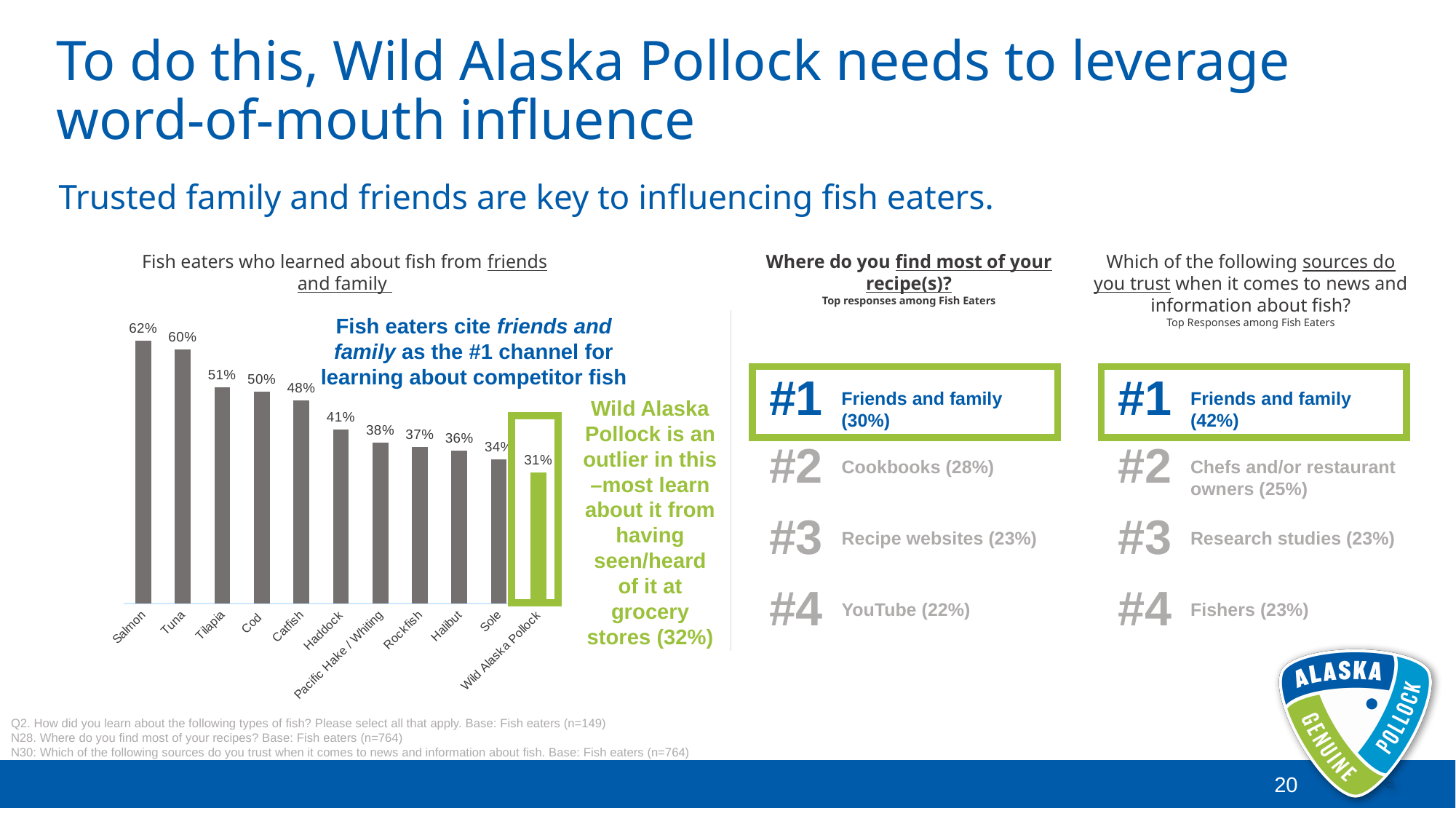
Which fish has the lowest share of fish eaters who learned about it from friends and family? Wild Alaska Pollock Which has a higher value, Tilapia or Rockfish? Tilapia What is the difference between the values for Salmon and Wild Alaska Pollock? 31% What kind of chart is used to show fish eaters who learned about fish from friends and family? Bar chart What is the value shown for Haddock in the bar chart? 41% Which fish has the highest share of fish eaters who learned about it from friends and family? Salmon What is the value shown for Wild Alaska Pollock in the bar chart? 31% How many fish types are shown in the bar chart? 11 Which bar in the chart is coloured green rather than grey? Wild Alaska Pollock What percentage of fish eaters learned about Salmon from friends and family? 62% Do the values in the bar chart rise or fall from left to right? Fall What is the difference between the values for Tuna and Cod? 10%